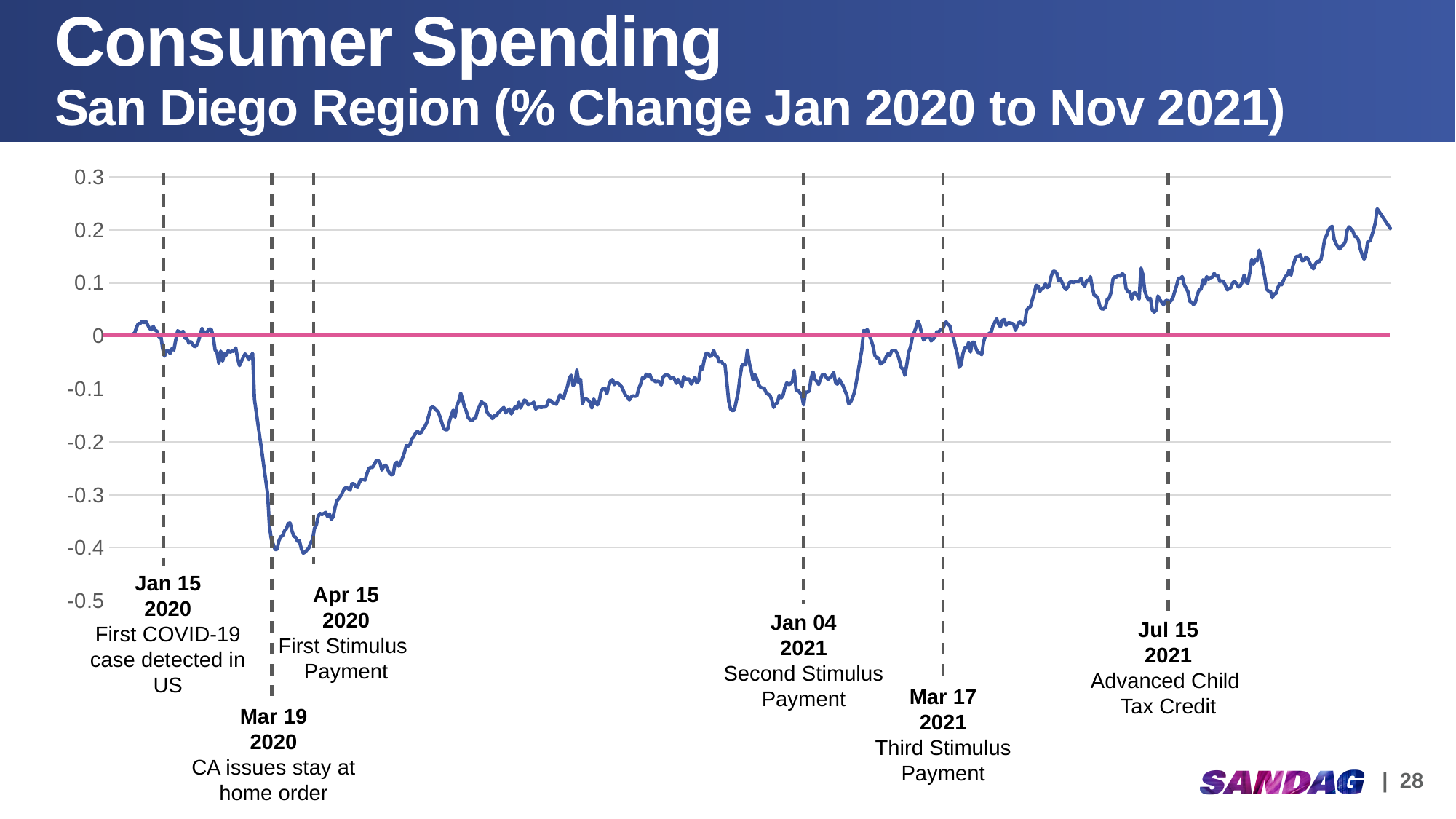
Is the value of the line at the far right end of the chart (Nov 2021) greater or less than 0.1? greater Does the line generally rise or fall between Apr 15 2020 and Nov 2021? rise Which is larger: the value of the line at the Jul 15 2021 dashed line or at the Jan 04 2021 dashed line? Jul 15 2021 Is the value of the line at the Jan 04 2021 dashed line greater or less than 0? less What is the lowest value shown on the y axis? -0.5 How many dated events are marked with dashed vertical lines on the chart? 6 What kind of chart is shown on the slide? line chart What event is labelled at the Mar 19 2020 dashed line? CA issues stay at home order Is the value of the line at the Jul 15 2021 dashed line greater or less than 0? greater Does the line rise or fall between Jan 15 2020 and Mar 19 2020? fall What is the title of the chart on the slide? Consumer Spending San Diego Region (% Change Jan 2020 to Nov 2021)